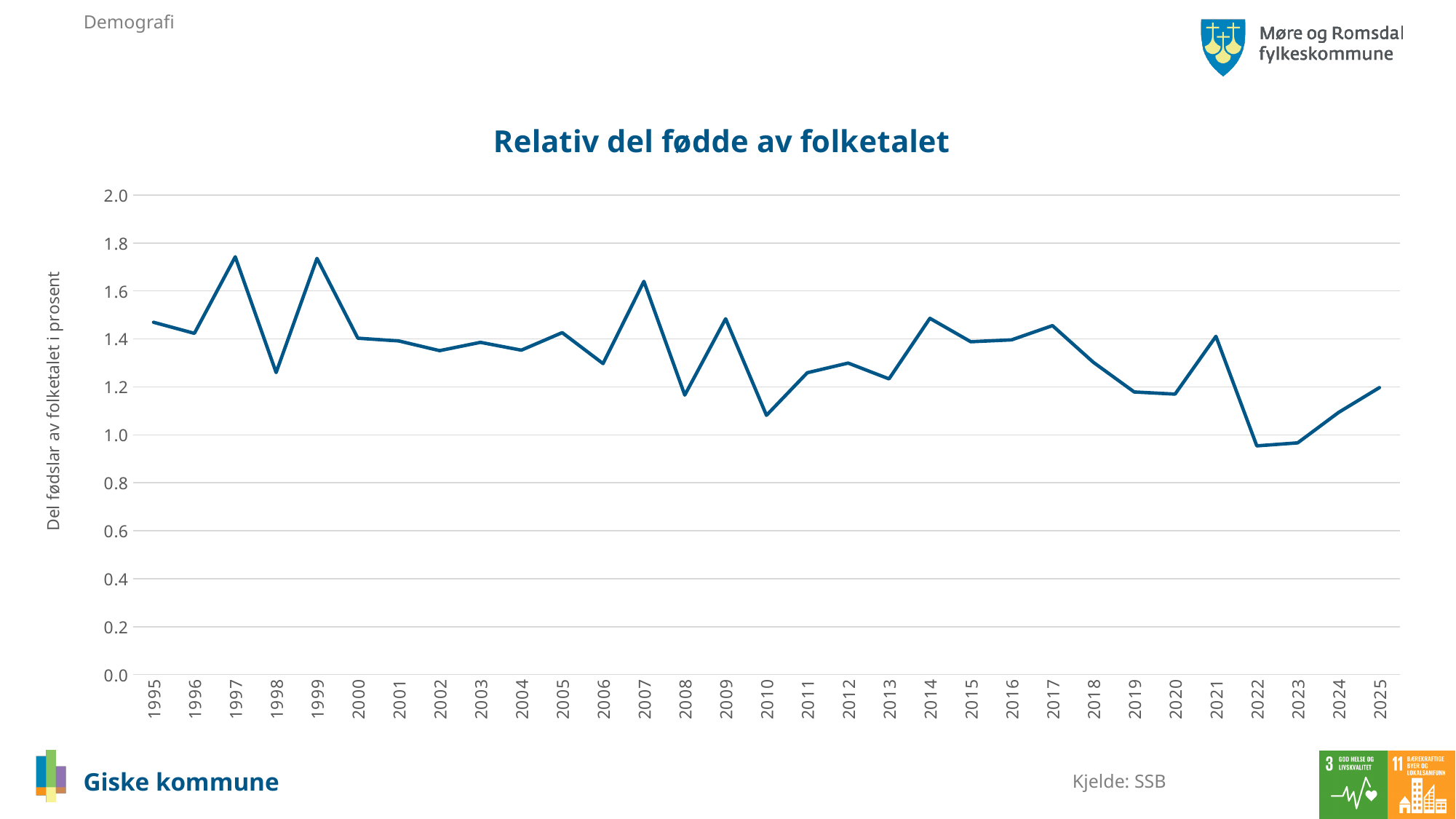
Do the values rise or fall from 2022 to 2025? rise What is the title of the chart? Relativ del fødde av folketalet How many years are shown along the x axis of the chart? 31 Is the value for 1998 greater or less than 1.4? less What kind of chart is shown on the slide? line chart Which year has the larger value, 2021 or 2022? 2021 Is the value for 2014 greater or less than 1.4? greater Is the value for 2010 greater or less than 1.2? less What is the label on the vertical axis of the chart? Del fødslar av folketalet i prosent Which year has the larger value, 1997 or 1998? 1997